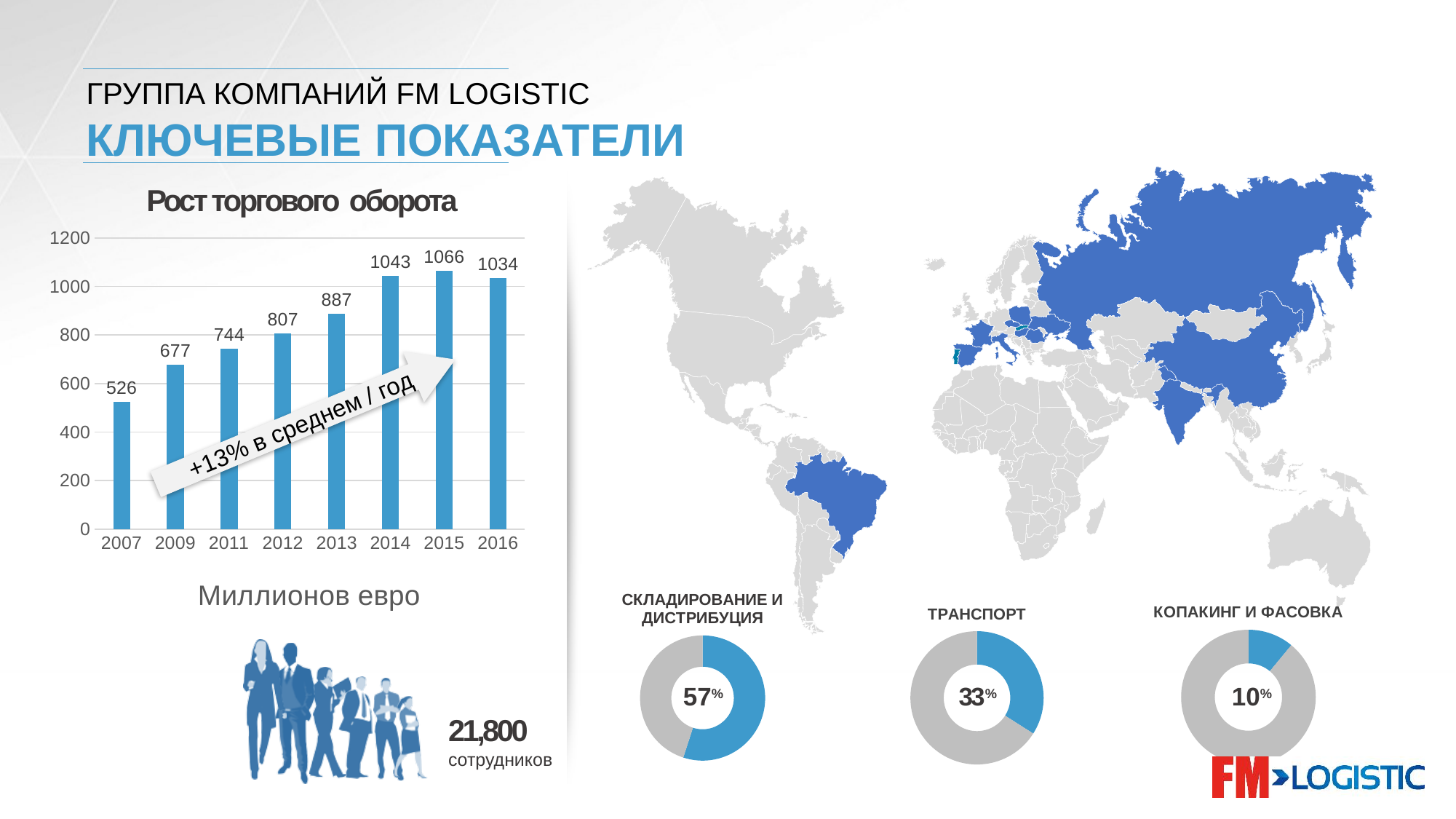
What kind of chart is the chart titled 'Рост торгового оборота'? bar chart In the chart titled 'Рост торгового оборота', which year has the highest value? 2015 In the chart titled 'Рост торгового оборота', what is the value for 2014? 1043 In the donut chart titled 'Копакинг и фасовка', what share is shown? 10% In the chart titled 'Рост торгового оборота', what is the difference between the values for 2016 and 2007? 508 In the chart titled 'Рост торгового оборота', which is larger, the value for 2015 or the value for 2016? 2015 In the chart titled 'Рост торгового оборота', which year has the lowest value? 2007 In the chart titled 'Рост торгового оборота', do the values generally rise or fall from 2007 to 2015? rise In the chart titled 'Рост торгового оборота', what is the value for 2007? 526 In the donut chart titled 'Транспорт', what share is shown? 33% In the donut chart titled 'Складирование и дистрибуция', what share is shown? 57% In the chart titled 'Рост торгового оборота', how many years are shown on the x axis? 8